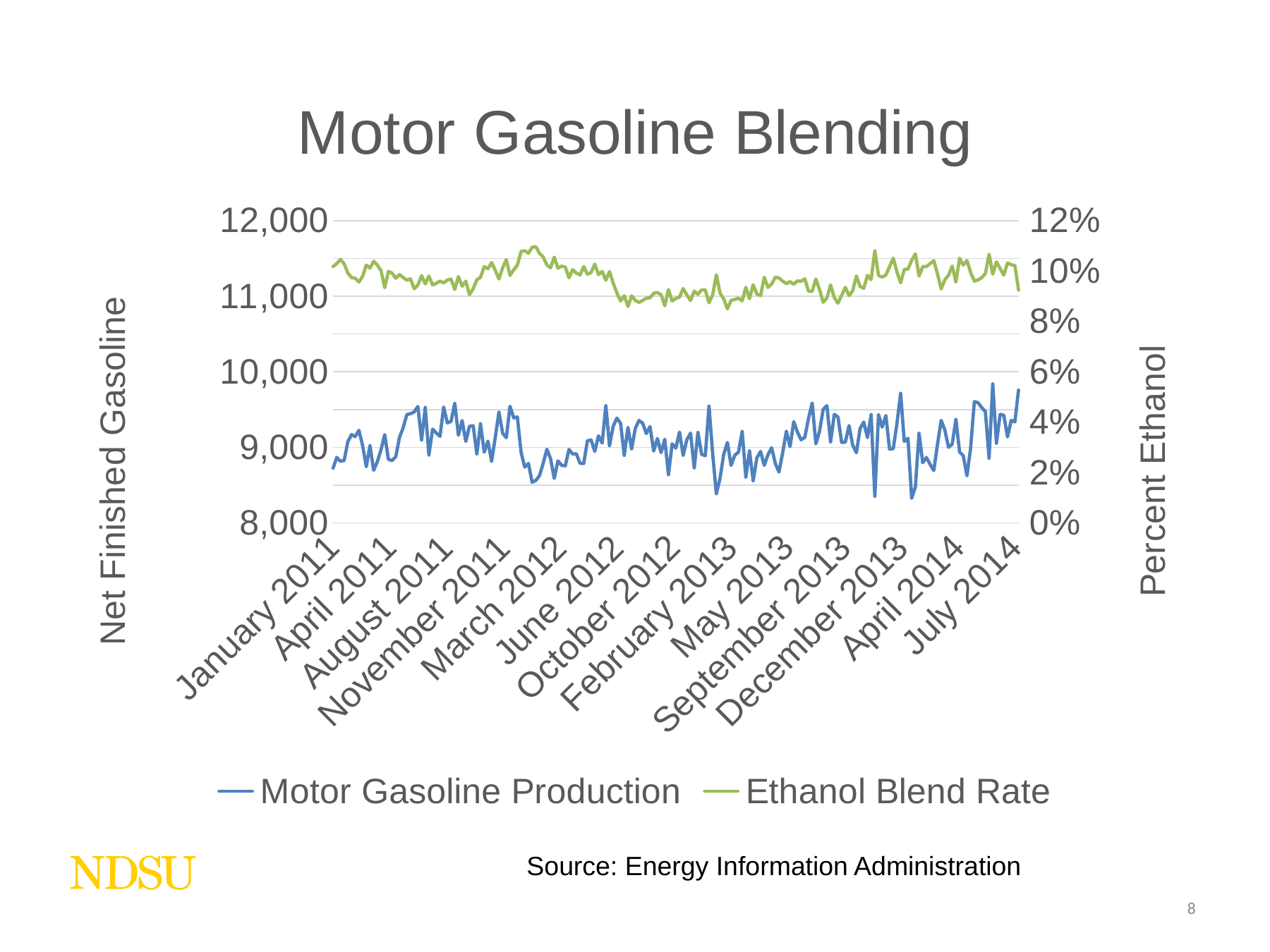
What kind of chart is shown on the slide? Line chart How many series does the legend list? 2 Does the Ethanol Blend Rate rise or fall between March 2012 and October 2012? fall Is the value for Ethanol Blend Rate in October 2012 greater or less than 12%? less Is the value for Ethanol Blend Rate in January 2011 greater or less than 8%? greater What is the title of the chart? Motor Gasoline Blending Is the value for Ethanol Blend Rate in July 2014 greater or less than 6%? greater Which series is drawn in green? Ethanol Blend Rate